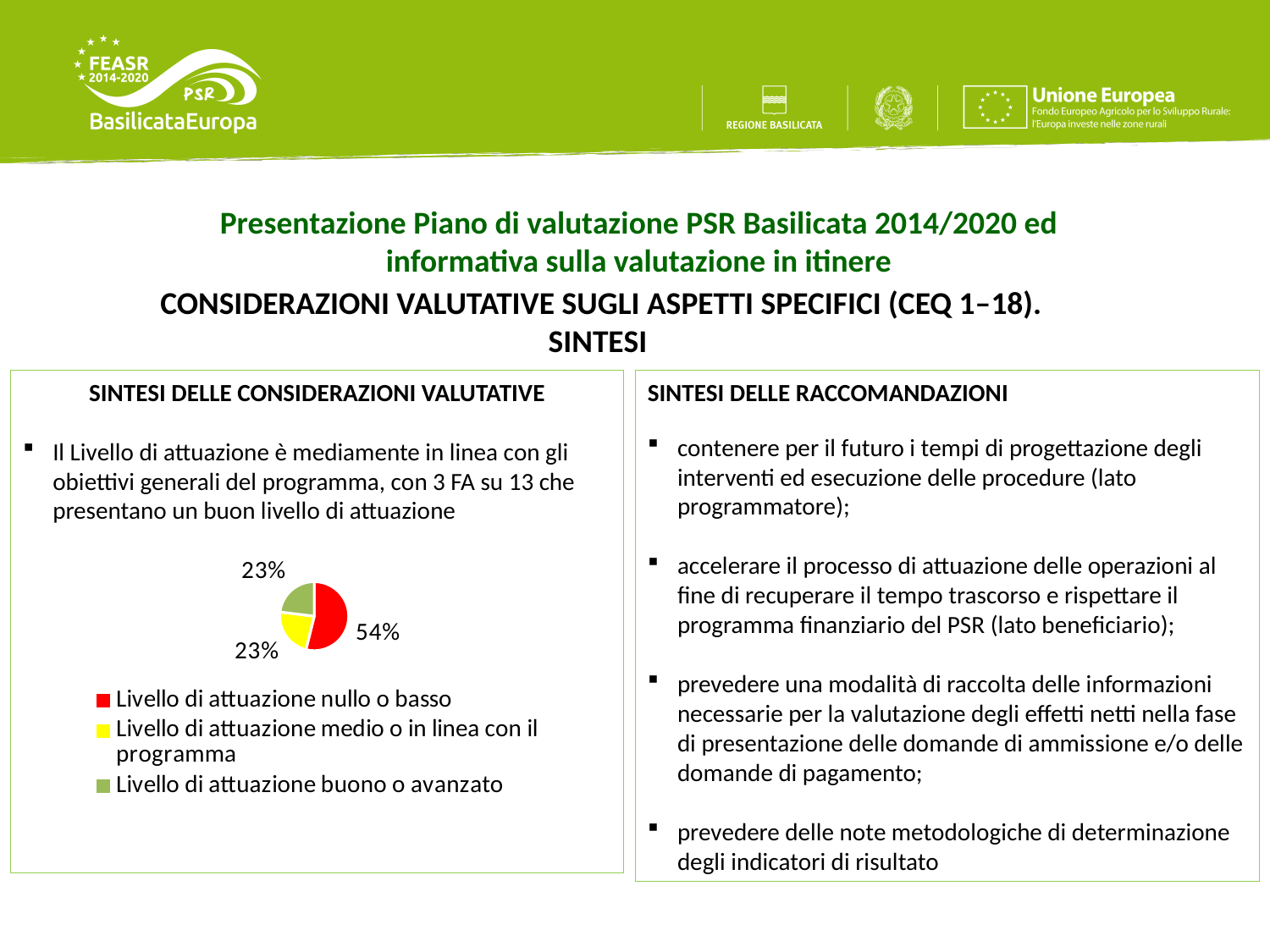
What colour is the slice for "Livello di attuazione buono o avanzato"? Green How many entries does the legend of the pie chart list? 3 Is the share for "Livello di attuazione nullo o basso" greater or less than 50%? greater What share of the pie does "Livello di attuazione buono o avanzato" represent? 23% What share of the pie does "Livello di attuazione nullo o basso" represent? 54% How many slices does the pie chart have? 3 Which category has the largest slice of the pie? Livello di attuazione nullo o basso Which is larger: the slice for "Livello di attuazione nullo o basso" or the slice for "Livello di attuazione medio o in linea con il programma"? Livello di attuazione nullo o basso What colour is the slice for "Livello di attuazione nullo o basso"? Red What is the difference in percentage points between "Livello di attuazione nullo o basso" and "Livello di attuazione buono o avanzato"? 31 What share of the pie does "Livello di attuazione medio o in linea con il programma" represent? 23% What kind of chart is shown on the slide? Pie chart